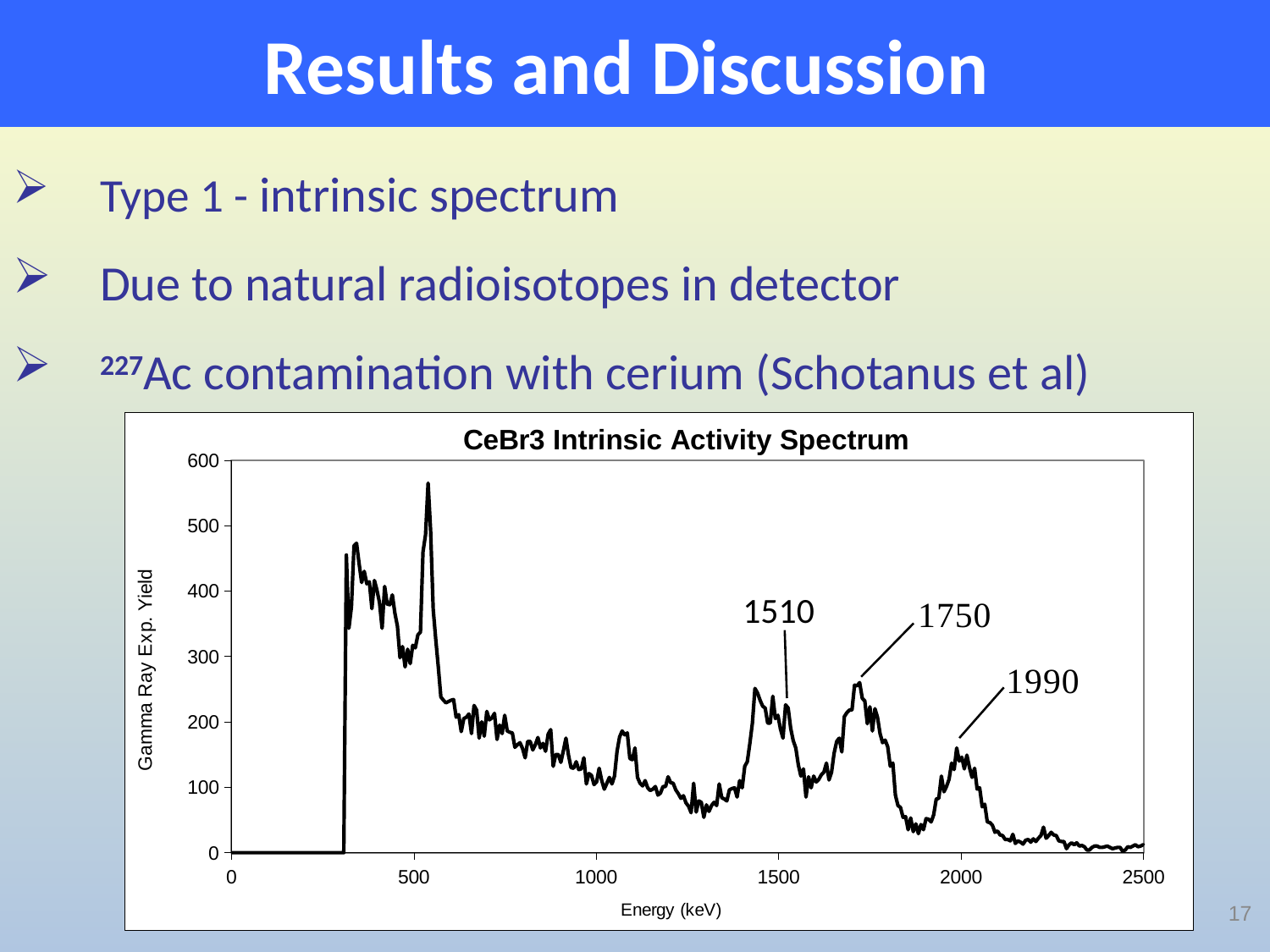
Is the yield at the peak annotated 1510 greater or less than 300? less Which annotated peak is higher, the one at 1750 or the one at 1990? 1750 How many energy values are annotated with labels on the chart? 3 What is the title of the chart? CeBr3 Intrinsic Activity Spectrum Is the yield at the peak annotated 1990 greater or less than 200? less Is the yield at the peak annotated 1750 greater or less than 200? greater What kind of chart is shown on the slide? line chart What is the label of the x axis of the chart? Energy (keV) Between 600 keV and 1300 keV, does the yield generally rise or fall as energy increases? fall